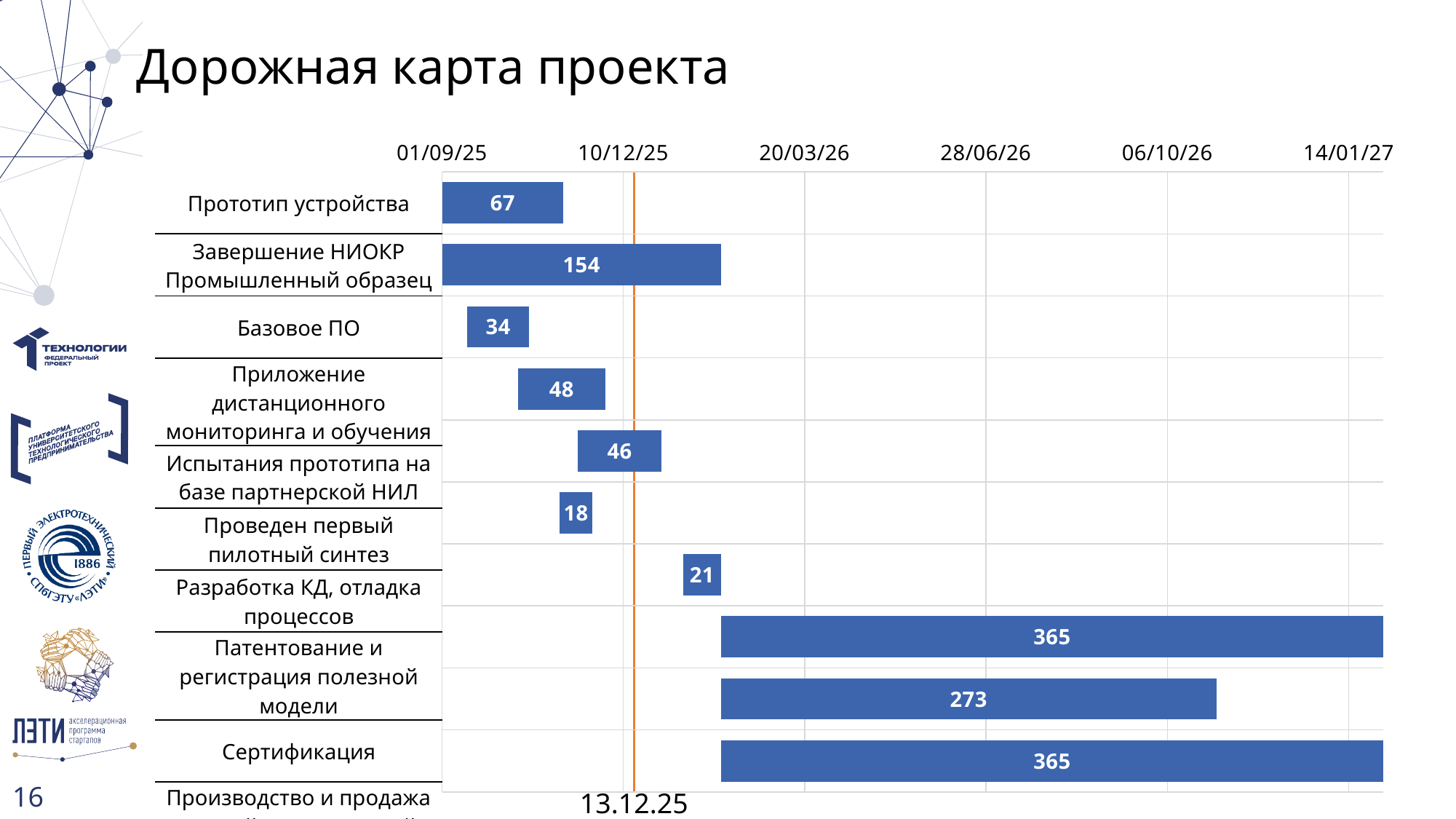
What is the difference between the values for Прототип устройства and Базовое ПО? 33 What is the smallest value labelled on any bar in the chart? 18 What date is marked by the vertical orange line on the chart? 13.12.25 Which has the larger value, Базовое ПО or Приложение дистанционного мониторинга и обучения? Приложение дистанционного мониторинга и обучения How many bars are labelled with the value 365? 2 What is the difference between the values for Завершение НИОКР Промышленный образец and Прототип устройства? 87 What kind of chart is shown on the slide? bar chart What is the value shown for Завершение НИОКР Промышленный образец? 154 What is the value shown for Прототип устройства? 67 What is the value shown for Приложение дистанционного мониторинга и обучения? 48 How many bars are plotted in the chart? 10 What is the value shown for Базовое ПО? 34